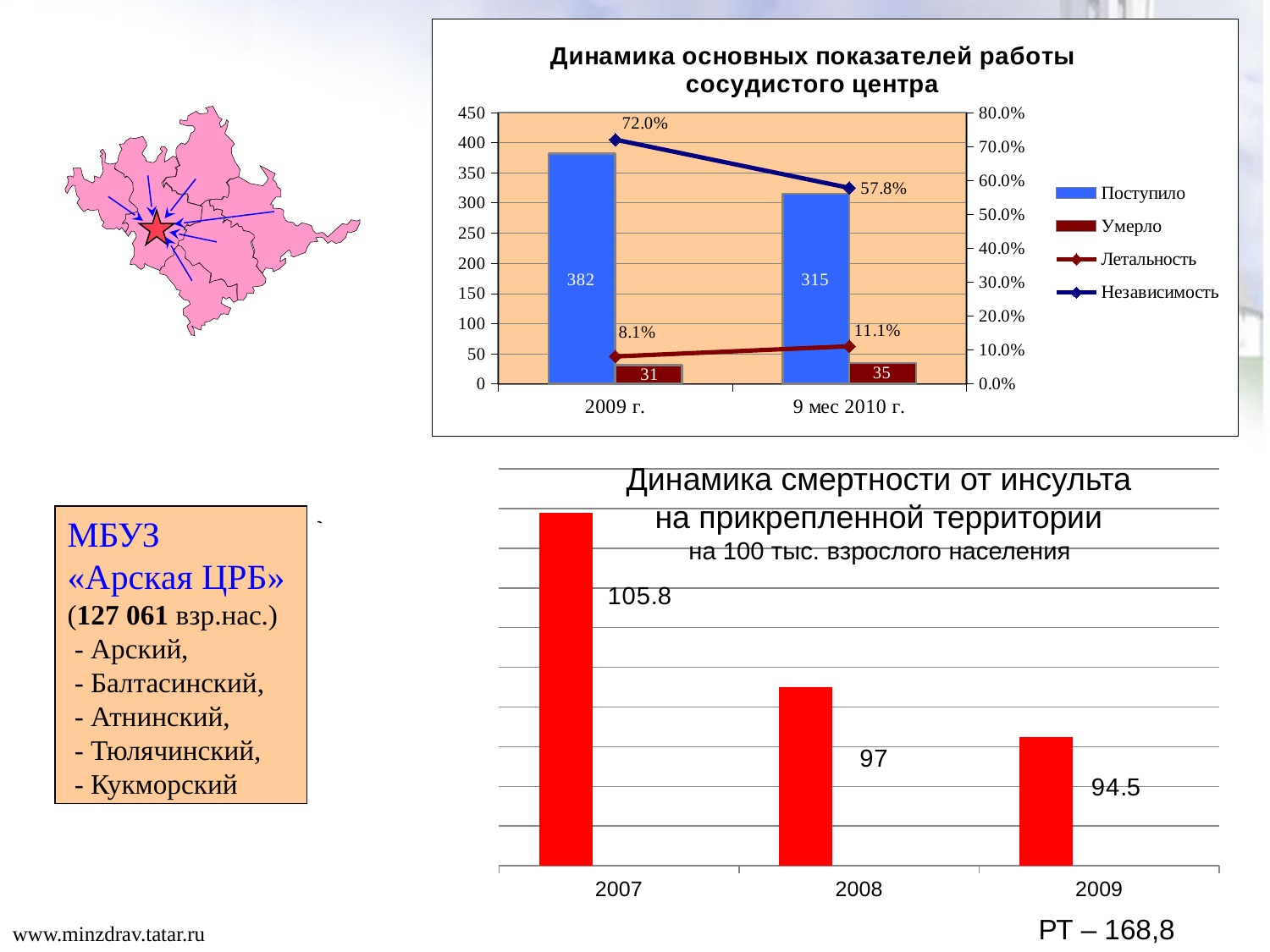
In the chart 'Динамика основных показателей работы сосудистого центра', does 'Независимость' rise or fall from 2009 г. to 9 мес 2010 г.? fall In the chart 'Динамика основных показателей работы сосудистого центра', what is the 'Летальность' value for 2009 г.? 8.1% In the chart 'Динамика смертности от инсульта на прикрепленной территории', how many years are shown on the x axis? 3 In the chart 'Динамика основных показателей работы сосудистого центра', by how much did 'Поступило' decrease from 2009 г. to 9 мес 2010 г.? 67 In the chart 'Динамика смертности от инсульта на прикрепленной территории', what is the difference between the 2007 and 2009 values? 11.3 In the chart 'Динамика основных показателей работы сосудистого центра', what is the 'Независимость' value for 9 мес 2010 г.? 57.8% What kind of chart is 'Динамика смертности от инсульта на прикрепленной территории'? bar chart In the chart 'Динамика основных показателей работы сосудистого центра', what is the value of 'Поступило' for 2009 г.? 382 In the chart 'Динамика смертности от инсульта на прикрепленной территории', which year has the highest value? 2007 In the chart 'Динамика смертности от инсульта на прикрепленной территории', what is the value for 2008? 97 In the chart 'Динамика основных показателей работы сосудистого центра', what is the value of 'Умерло' for 9 мес 2010 г.? 35 In the chart 'Динамика основных показателей работы сосудистого центра', how many series does the legend list? 4